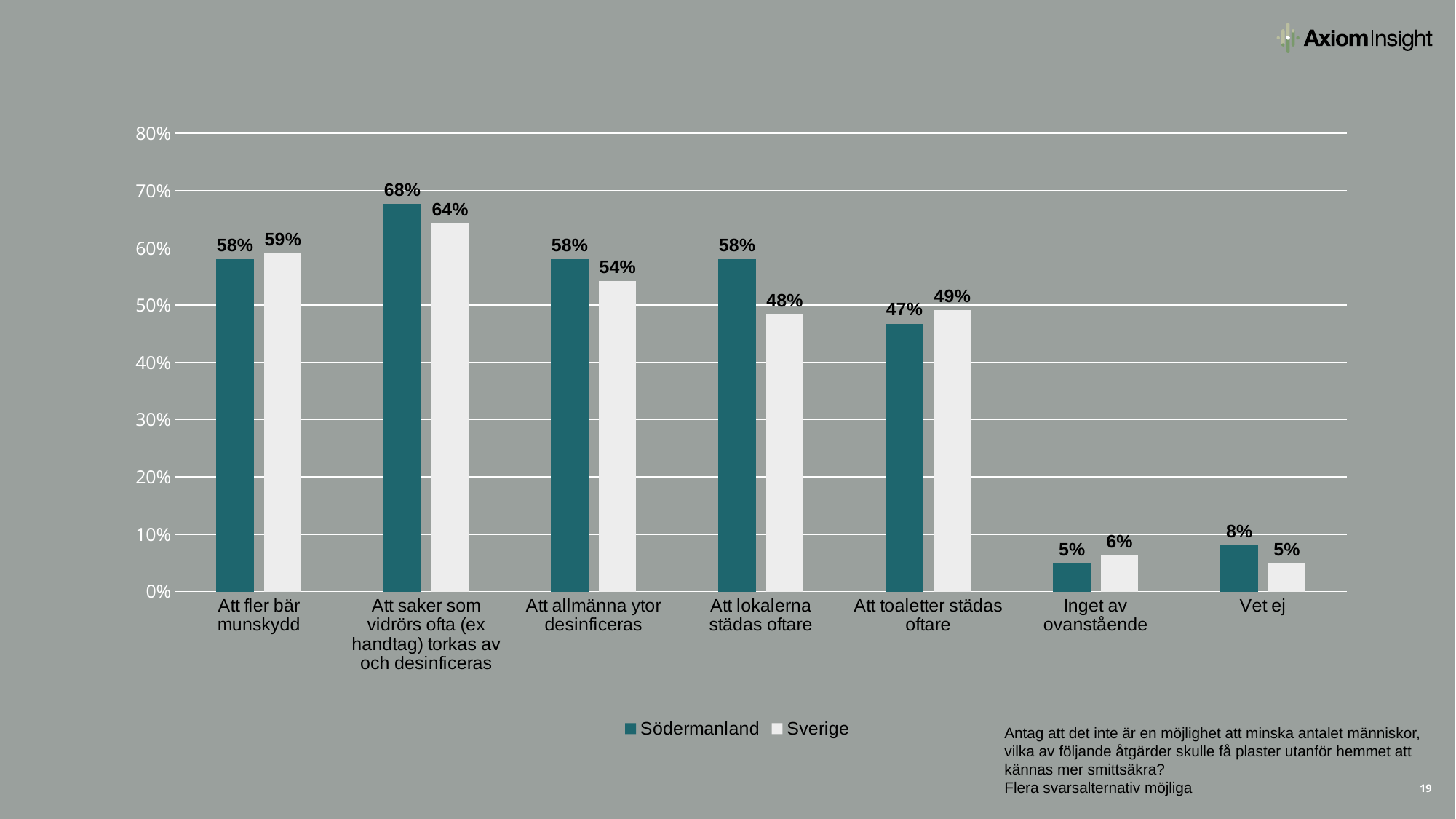
What is the value for Sverige for "Att lokalerna städas oftare"? 48% What is the value for Sverige for "Vet ej"? 5% For "Att toaletter städas oftare", which is larger: Södermanland or Sverige? Sverige Which category has the highest value for Södermanland? Att saker som vidrörs ofta (ex handtag) torkas av och desinficeras How many categories are shown on the x axis? 7 What is the value for Södermanland for "Att saker som vidrörs ofta (ex handtag) torkas av och desinficeras"? 68% Which category has the lowest value for Sverige? Vet ej Which series is shown in dark teal in the legend? Södermanland What kind of chart is shown on the slide? Bar chart How many series does the legend list? 2 Is the Södermanland value for "Att fler bär munskydd" greater or less than 50%? greater What is the difference between the Södermanland and Sverige values for "Att allmänna ytor desinficeras"? 4%